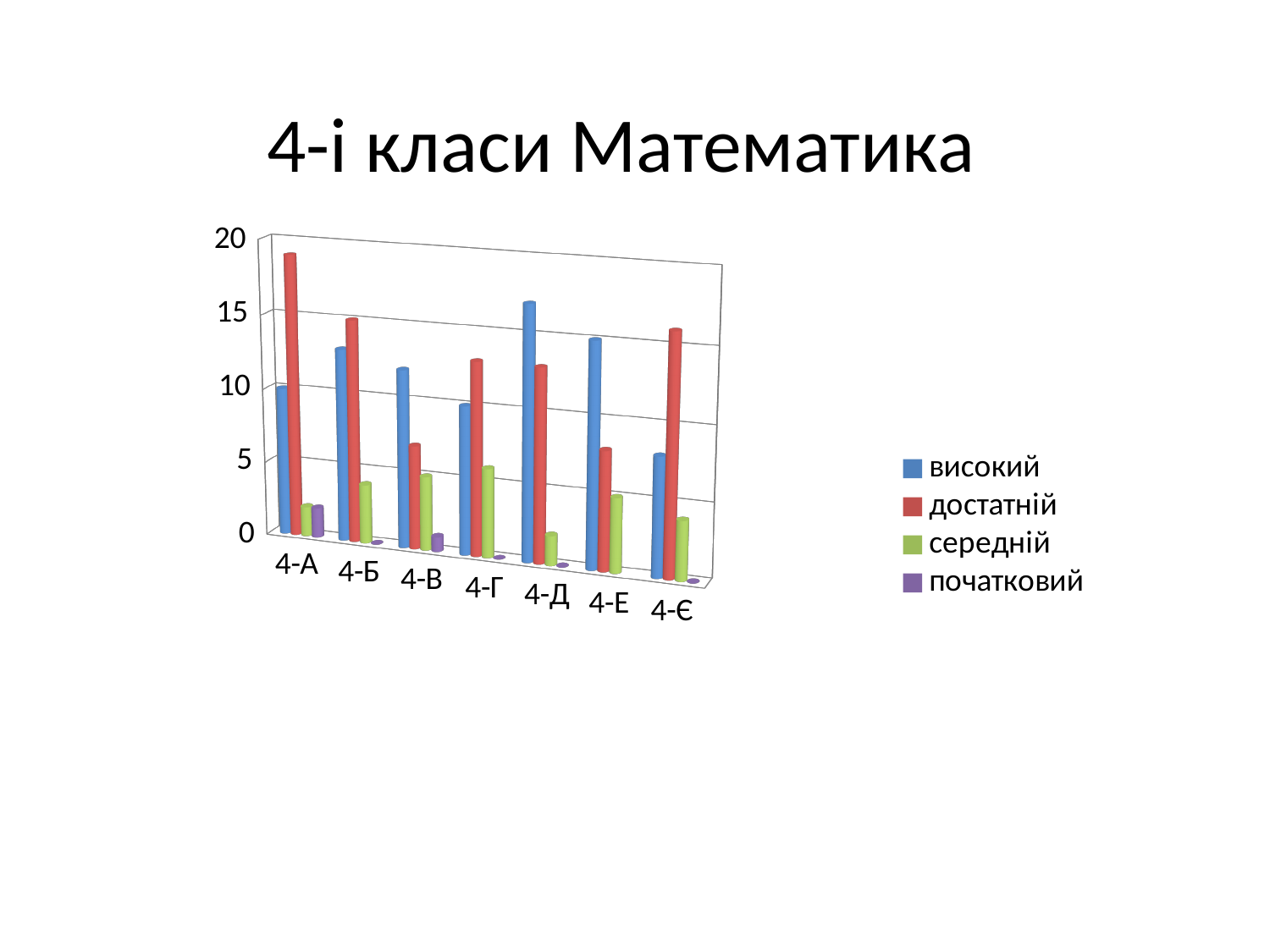
Which class has the highest value for достатній? 4-А Is the value for достатній in class 4-В greater or less than 10? less How many series does the legend list? 4 What is the title of the chart? 4-і класи Математика In class 4-А, which is larger: високий or достатній? достатній What kind of chart is shown on the slide? bar chart How many classes (categories) are shown on the x axis? 7 In class 4-В, which is larger: високий or достатній? високий Which class has the highest value for високий? 4-Д Is the value for достатній in class 4-А greater or less than 15? greater Is the value for середній in class 4-А greater or less than 5? less